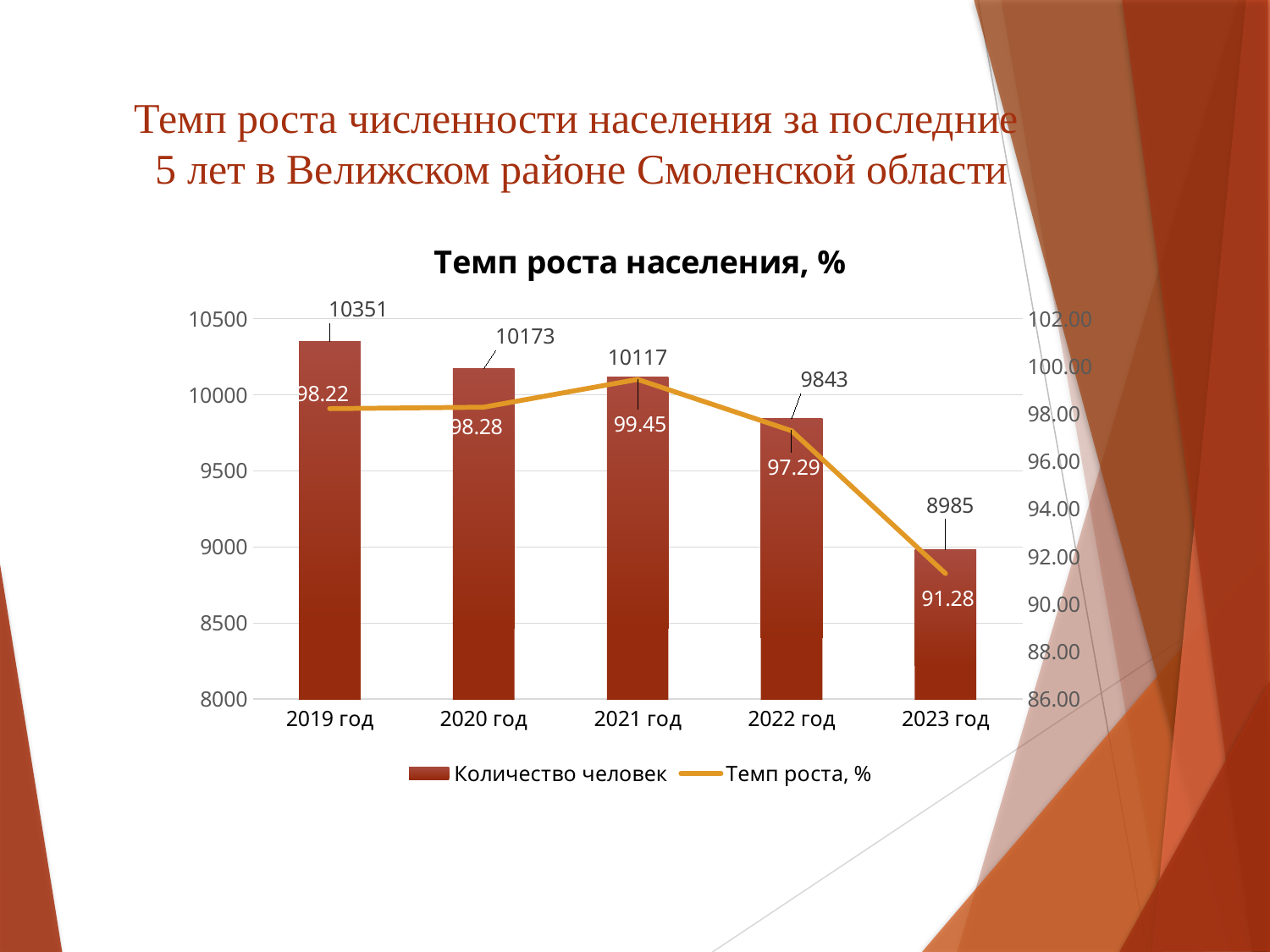
What is the value of Темп роста, % for 2022 год? 97.29 What kind of chart is used for the Количество человек series? Bar chart What is the value of Темп роста, % for 2021 год? 99.45 What is the value of Количество человек for 2023 год? 8985 How many series does the legend list? 2 How many years are shown on the x axis? 5 Does Количество человек rise or fall from 2019 год to 2023 год? Fall Which year has the highest Количество человек? 2019 год Which year has the lowest Темп роста, %? 2023 год Which is larger, Темп роста, % for 2020 год or for 2019 год? 2020 год What is the value of Количество человек for 2019 год? 10351 What is the difference in Количество человек between 2019 год and 2023 год? 1366